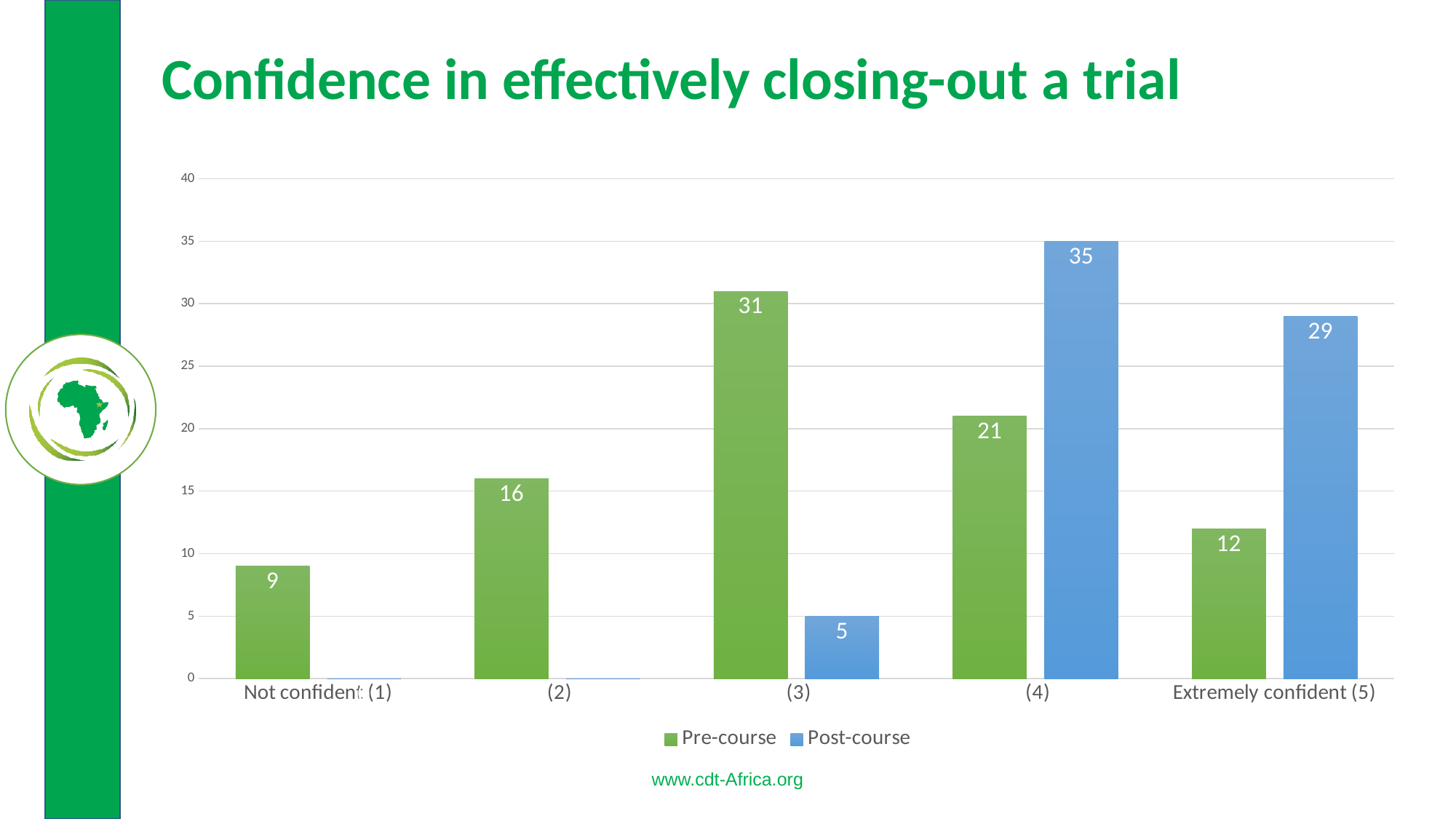
What is the Post-course value for category (4)? 35 Which category has the highest Pre-course value? (3) What is the Pre-course value for category (3)? 31 What is the difference between the Post-course and Pre-course values for category (4)? 14 Which category has the lowest Pre-course value? Not confident (1) What kind of chart is shown on the slide? Bar chart What is the title of the chart? Confidence in effectively closing-out a trial How many series does the legend list? 2 How many categories are shown on the x axis? 5 What is the Post-course value for category (3)? 5 Which is larger for Extremely confident (5): the Pre-course value or the Post-course value? Post-course What is the Pre-course value for Extremely confident (5)? 12